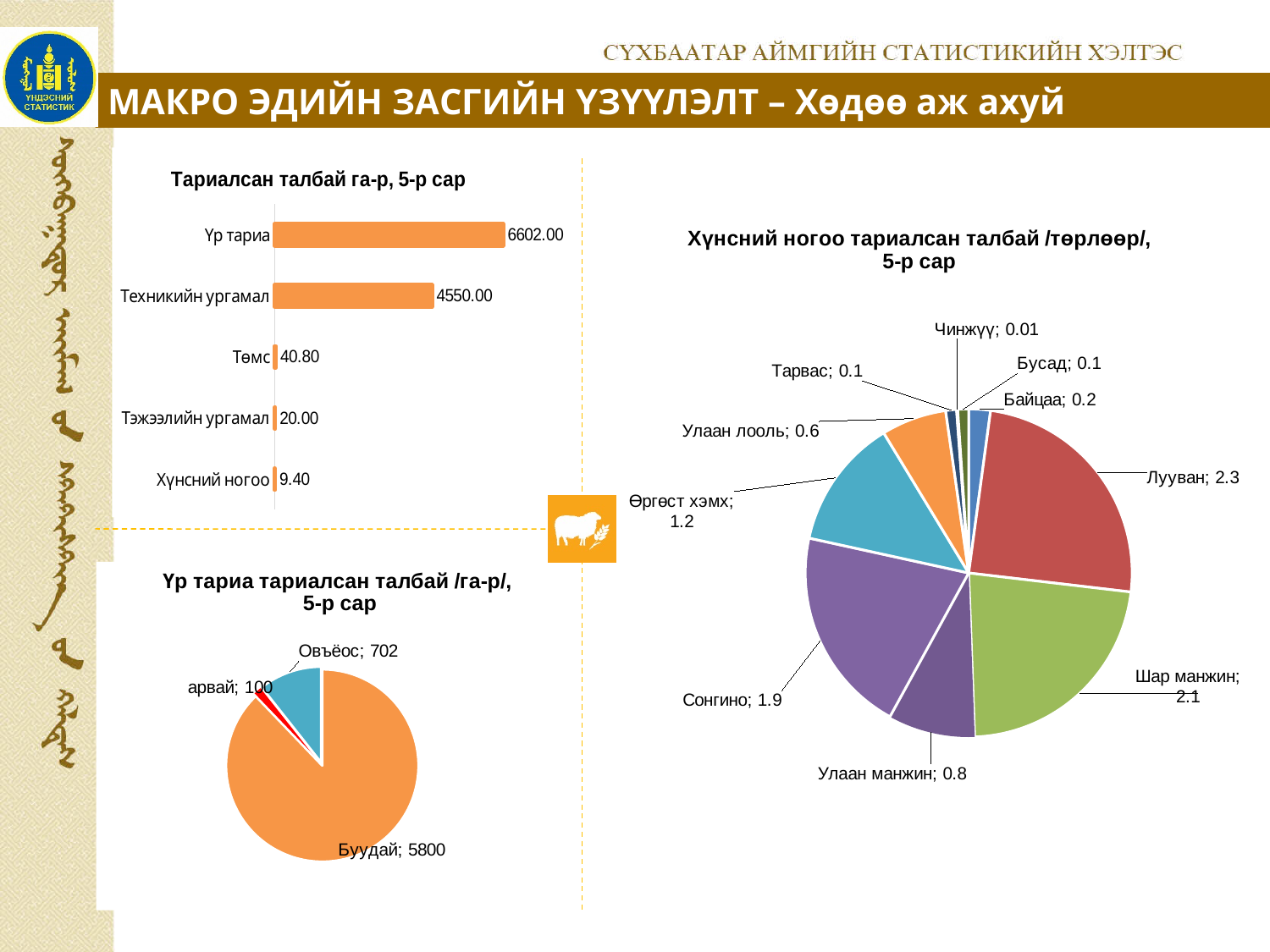
In the pie chart 'Хүнсний ногоо тариалсан талбай /төрлөөр/, 5-р сар', which slice is the smallest? Чинжүү What type of chart is 'Тариалсан талбай га-р, 5-р сар'? Bar chart In the bar chart 'Тариалсан талбай га-р, 5-р сар', which category has the highest value? Үр тариа In the pie chart 'Үр тариа тариалсан талбай /га-р/, 5-р сар', which slice is the largest? Буудай In the pie chart 'Хүнсний ногоо тариалсан талбай /төрлөөр/, 5-р сар', which is larger, Лууван or Шар манжин? Лууван In the pie chart 'Үр тариа тариалсан талбай /га-р/, 5-р сар', what is the value for Овъёос? 702 How many categories are shown in the bar chart 'Тариалсан талбай га-р, 5-р сар'? 5 How many slices does the pie chart 'Үр тариа тариалсан талбай /га-р/, 5-р сар' have? 3 In the bar chart 'Тариалсан талбай га-р, 5-р сар', what is the difference between Үр тариа and Техникийн ургамал? 2052.00 In the pie chart 'Хүнсний ногоо тариалсан талбай /төрлөөр/, 5-р сар', what is the value for Сонгино? 1.9 In the bar chart 'Тариалсан талбай га-р, 5-р сар', which category has the lowest value? Хүнсний ногоо In the bar chart 'Тариалсан талбай га-р, 5-р сар', what is the value for Техникийн ургамал? 4550.00